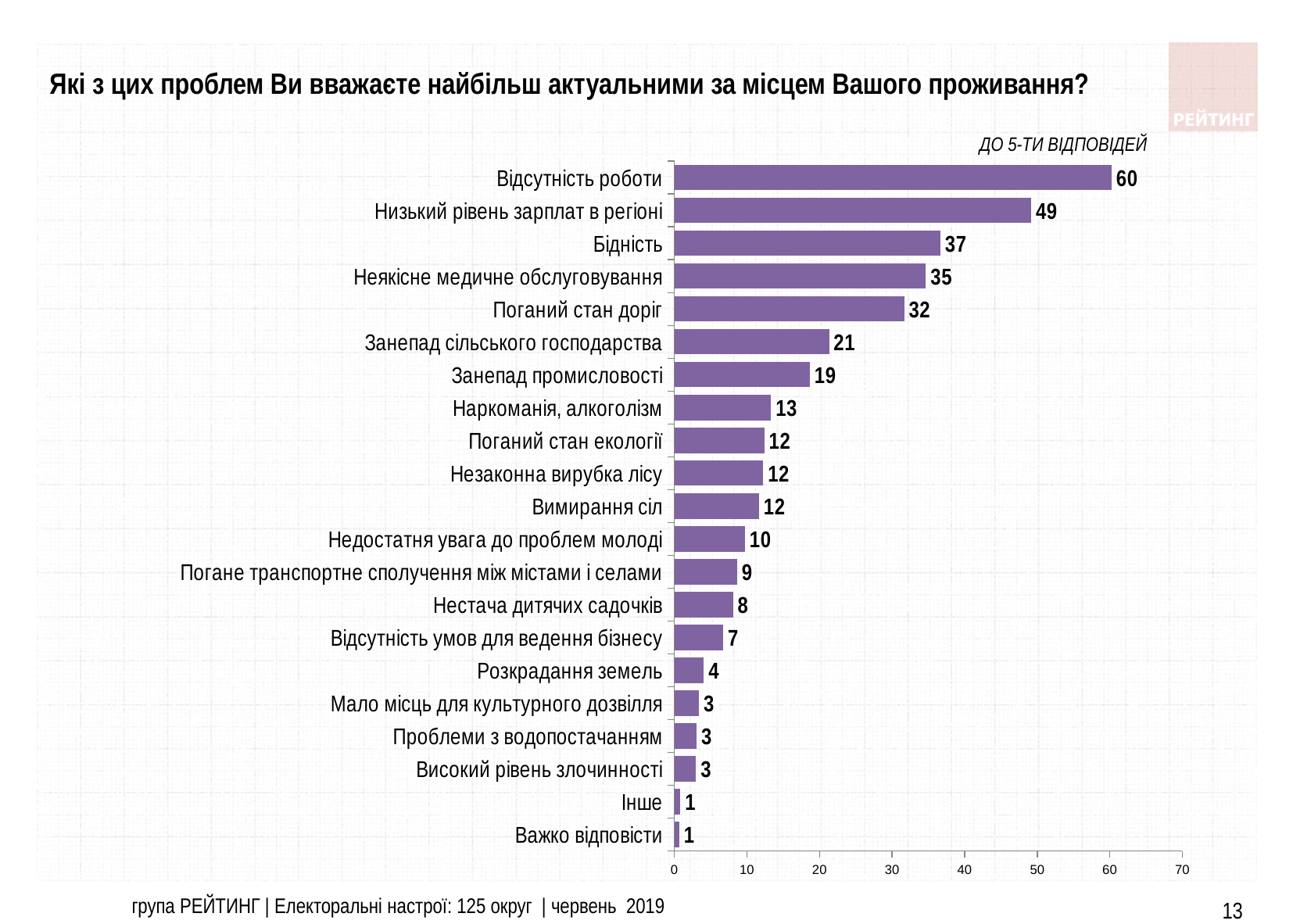
What is the highest tick value shown on the horizontal axis? 70 What is the difference between the values for "Відсутність роботи" and "Низький рівень зарплат в регіоні"? 11 What is the difference between the values for "Бідність" and "Занепад промисловості"? 18 What is the value for "Важко відповісти"? 1 Is the value for "Низький рівень зарплат в регіоні" greater or less than 40? greater What kind of chart is shown on the slide? bar chart How many categories are shown in the chart? 21 What is the value for "Відсутність роботи"? 60 What is the value for "Поганий стан доріг"? 32 What is the value for "Нестача дитячих садочків"? 8 Which is larger, the value for "Неякісне медичне обслуговування" or the value for "Занепад сільського господарства"? Неякісне медичне обслуговування Which category has the highest value? Відсутність роботи